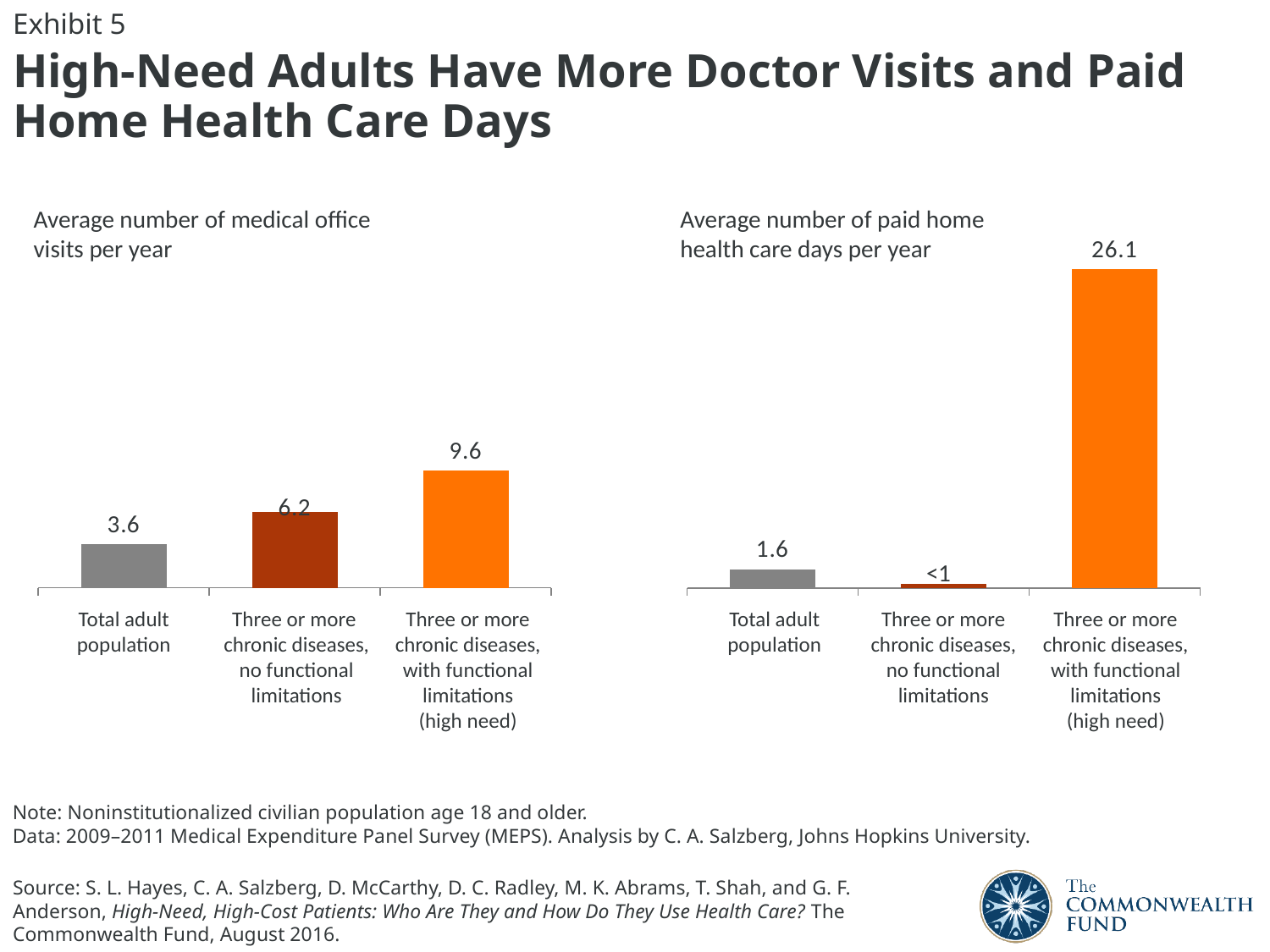
In the 'Average number of medical office visits per year' chart, what is the difference between the high-need group and the total adult population? 6.0 In the 'Average number of medical office visits per year' chart, what is the value for the total adult population? 3.6 In the 'Average number of medical office visits per year' chart, what is the value for adults with three or more chronic diseases and no functional limitations? 6.2 In the 'Average number of paid home health care days per year' chart, which category has the lowest value? Three or more chronic diseases, no functional limitations What type of chart is used for 'Average number of paid home health care days per year'? Bar chart In the 'Average number of paid home health care days per year' chart, what is the difference between the high-need group and the total adult population? 24.5 In the 'Average number of paid home health care days per year' chart, what is the value for the total adult population? 1.6 In the 'Average number of medical office visits per year' chart, which category has the highest value? Three or more chronic diseases, with functional limitations (high need) How many categories are shown in the 'Average number of medical office visits per year' chart? 3 In the 'Average number of medical office visits per year' chart, what is the value for the high-need group (three or more chronic diseases with functional limitations)? 9.6 In the 'Average number of paid home health care days per year' chart, what is the value for the high-need group? 26.1 In the 'Average number of paid home health care days per year' chart, what label is shown for adults with three or more chronic diseases and no functional limitations? <1